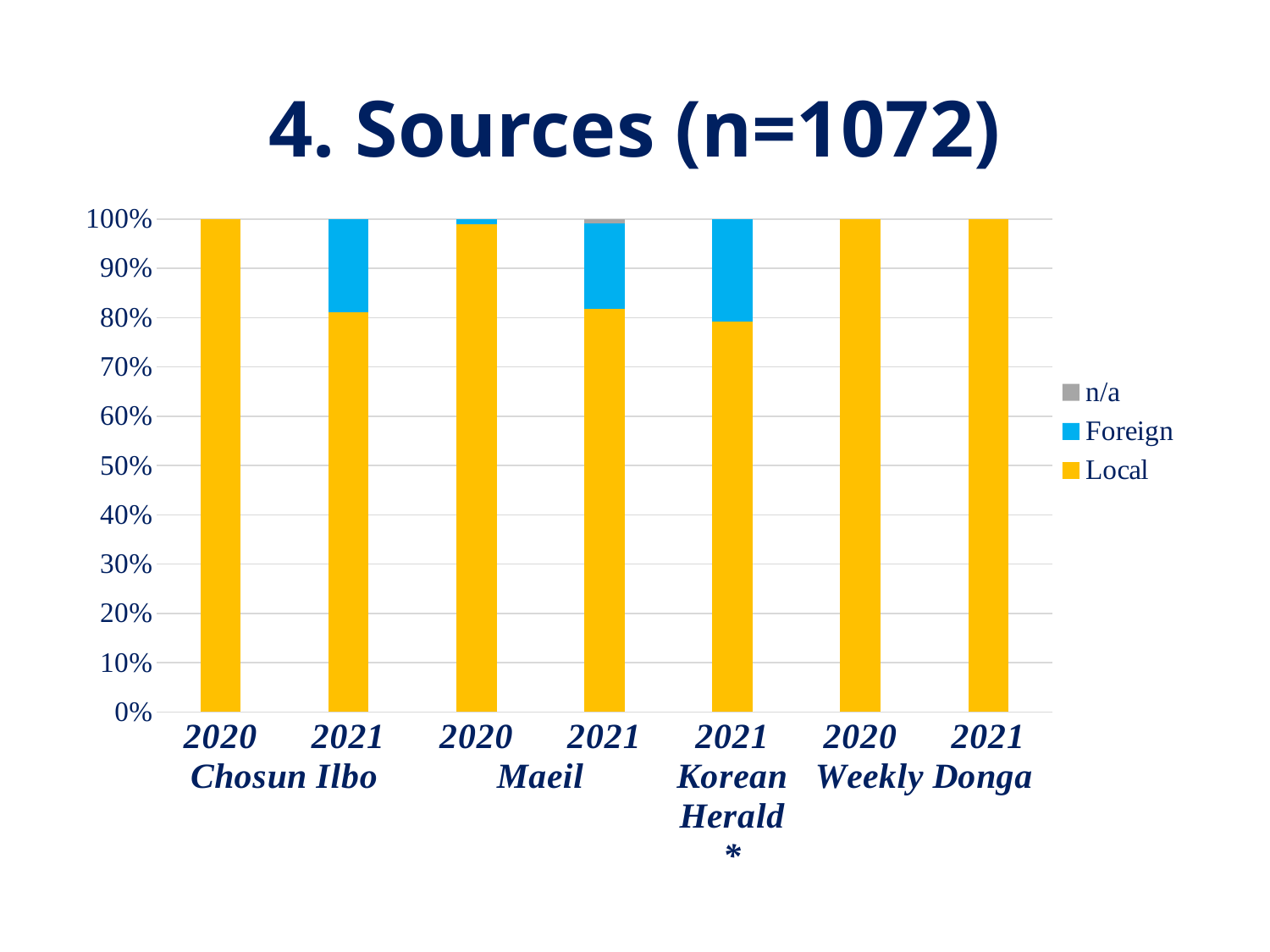
Is the Local share for 2021 Chosun Ilbo greater or less than 90%? less How many bars are plotted in the chart? 7 What is the total of the stacked bar for 2021 Chosun Ilbo? 100% What is the title of the chart? 4. Sources (n=1072) Is the Local share for 2021 Maeil greater or less than 70%? greater Which has the larger Foreign share, 2021 Chosun Ilbo or 2020 Maeil? 2021 Chosun Ilbo What is the Local share for 2021 Weekly Donga? 100% Is the Local share for 2021 Korean Herald * greater or less than 90%? less What is the Local share for 2020 Chosun Ilbo? 100% What kind of chart is shown on the slide? stacked bar chart Which has the larger Local share, 2020 Maeil or 2021 Maeil? 2020 Maeil How many series does the legend list? 3